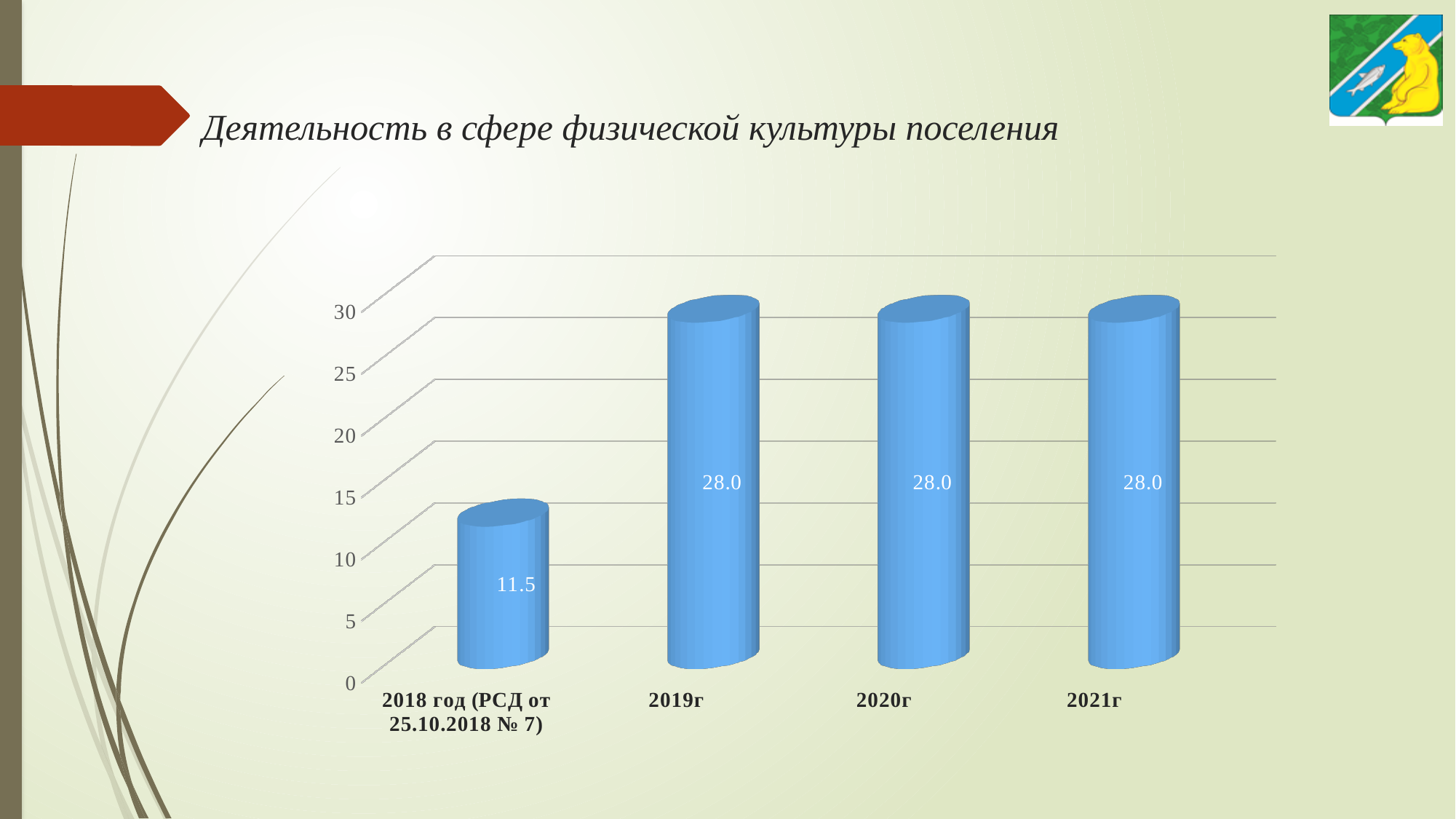
What is the value for 2018 год (РСД от 25.10.2018 № 7)? 11.5 Which is larger, the value for 2020г or the value for 2018 год (РСД от 25.10.2018 № 7)? 2020г Do the values rise or fall from 2018 to 2019? rise What is the difference between the values for 2019г and 2018 год (РСД от 25.10.2018 № 7)? 16.5 What is the value for 2021г? 28.0 Is the value for 2018 год (РСД от 25.10.2018 № 7) greater or less than 15? less Is the value for 2020г greater or less than 25? greater What kind of chart is shown on the slide? bar chart How many categories are shown on the x axis? 4 What is the value for 2019г? 28.0 What is the title of the slide? Деятельность в сфере физической культуры поселения Which category has the lowest value? 2018 год (РСД от 25.10.2018 № 7)